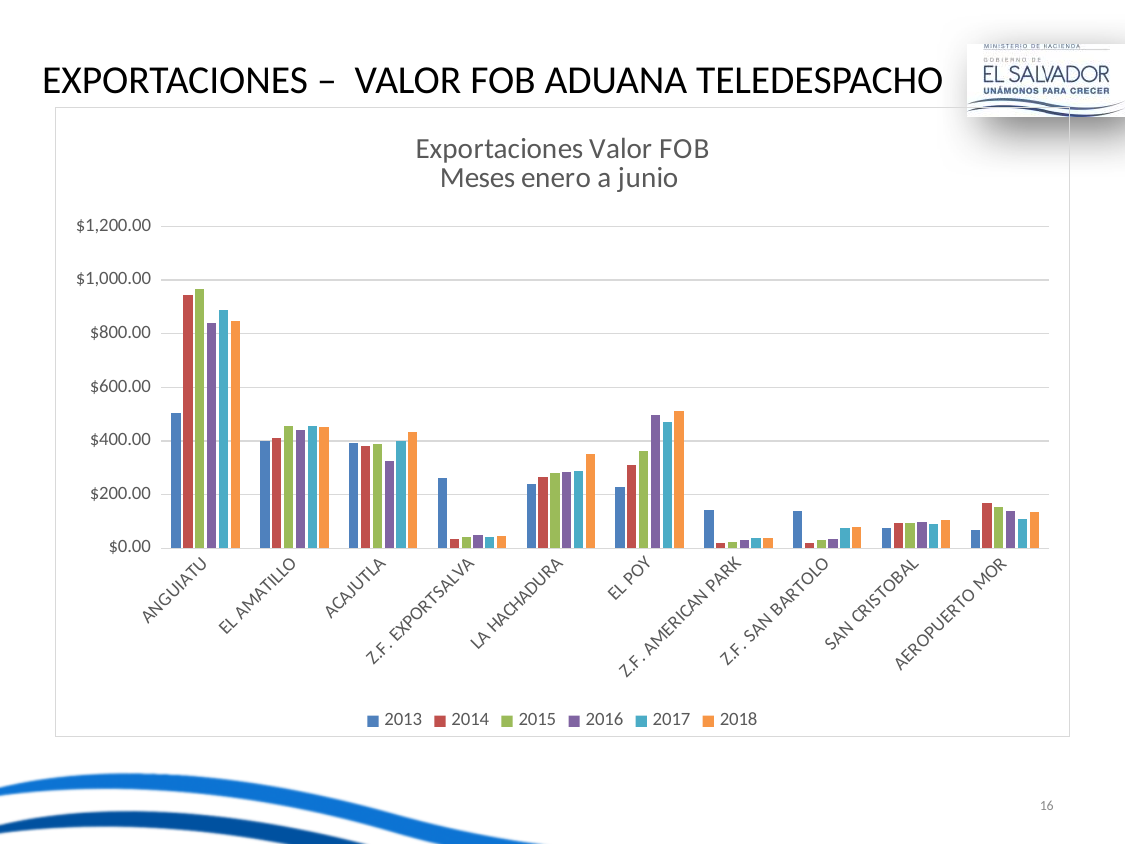
What kind of chart is shown on the slide? bar chart Is the value for LA HACHADURA in 2018 greater or less than $400.00? less Which year has the lowest bar for ANGUIATU? 2013 How many categories are shown on the x axis? 10 Is the value for ANGUIATU in 2015 greater or less than $800.00? greater Which category has the highest values overall? ANGUIATU Which year has the tallest bar for ANGUIATU? 2015 Is the value for EL POY in 2018 greater or less than $400.00? greater For ANGUIATU, which is larger: the 2014 value or the 2018 value? 2014 How many series does the legend list? 6 Do the values for LA HACHADURA rise or fall from 2013 to 2018? rise